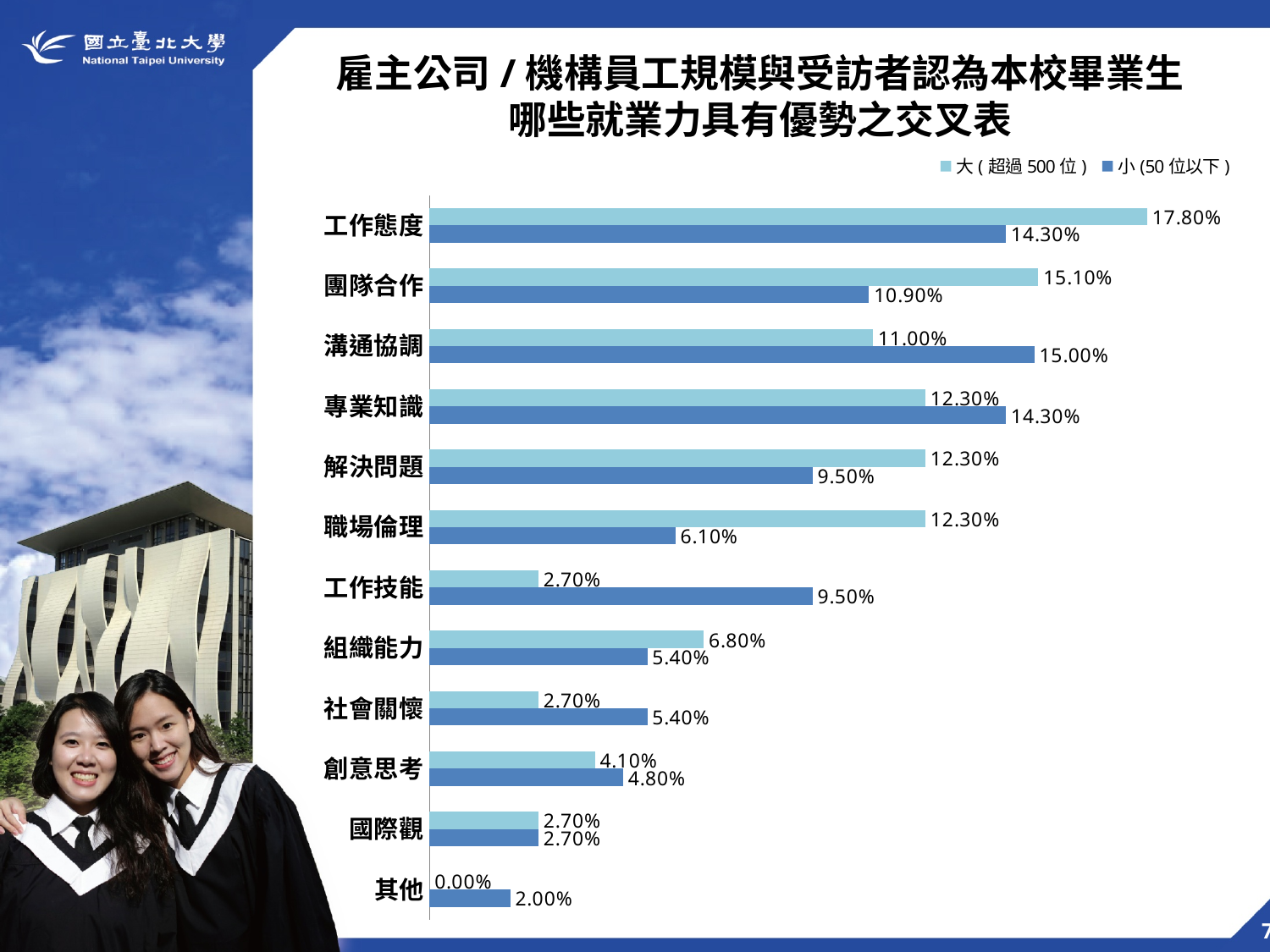
How many series does the legend list? 2 How many categories are shown on the chart? 12 Which category has the highest value in the 大(超過500位) series? 工作態度 What is the value for 工作態度 in the 大(超過500位) series? 17.80% What is the value for 職場倫理 in the 小(50位以下) series? 6.10% What is the value for 溝通協調 in the 小(50位以下) series? 15.00% Which category has the lowest value in the 小(50位以下) series? 其他 For 工作技能, which series has the larger value, 大(超過500位) or 小(50位以下)? 小(50位以下) What is the difference between the 大(超過500位) and 小(50位以下) values for 團隊合作? 4.20% What is the value for 其他 in the 大(超過500位) series? 0.00% Which colour represents the 小(50位以下) series in the legend? Dark blue What type of chart is shown on the slide? Bar chart